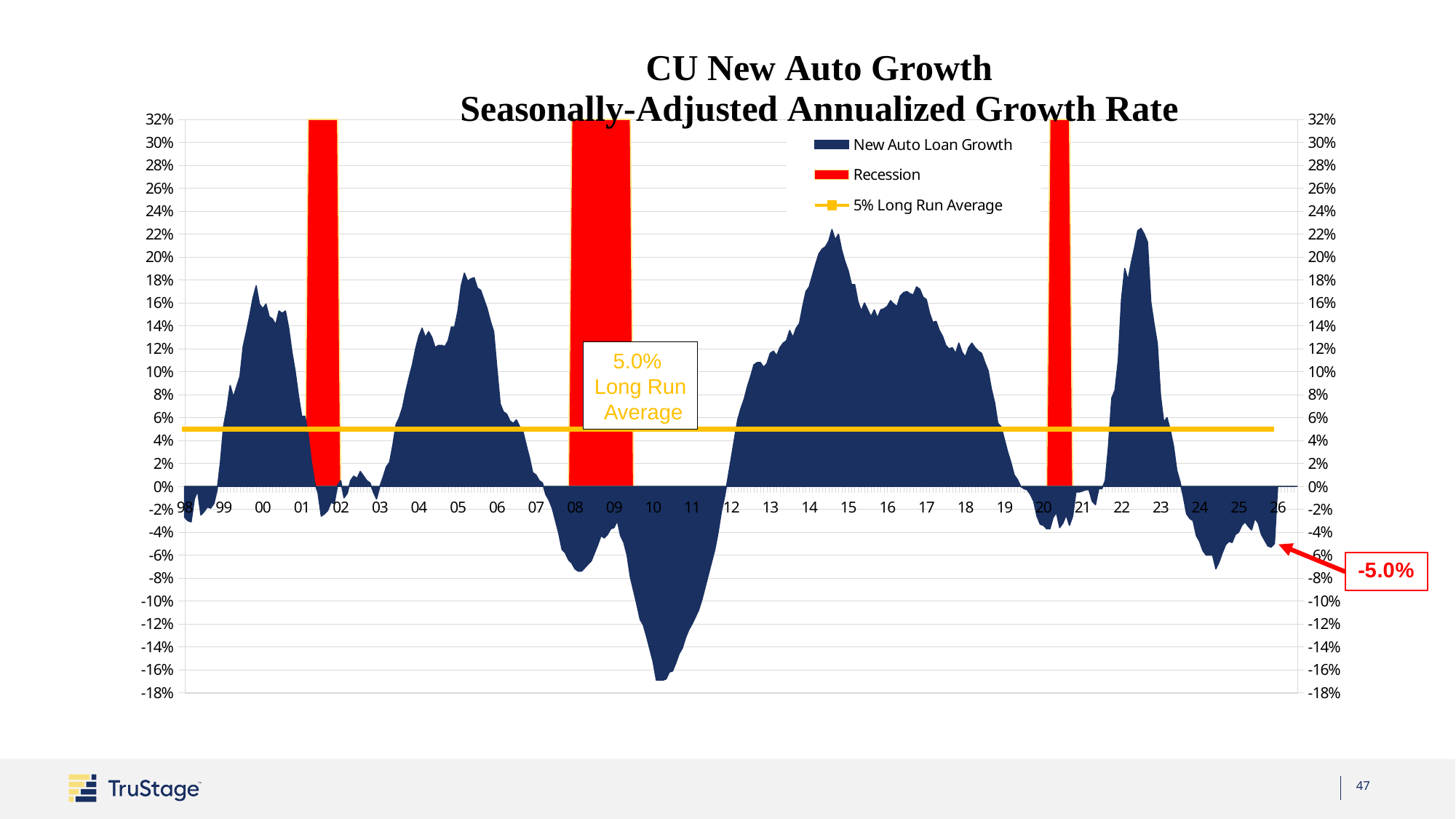
What is the title of the chart? CU New Auto Growth Seasonally-Adjusted Annualized Growth Rate What value does the yellow horizontal line represent, according to the label on the chart? 5.0% Long Run Average Is the lowest value of New Auto Loan Growth, reached around 2010, greater or less than -10%? less How many recession periods are shaded in red on the chart? 3 Is the peak of New Auto Loan Growth around 2014-2015 greater or less than 20%? greater How many series does the chart legend list? 3 Does New Auto Loan Growth rise or fall between 2022 and 2024? fall Does New Auto Loan Growth rise or fall between 2012 and 2014? rise What is the most recent value of New Auto Loan Growth, as shown by the red annotation at the right end of the chart? -5.0% What colour is used for the New Auto Loan Growth series? Dark blue (navy) Is the peak of New Auto Loan Growth around 2022 greater or less than 20%? greater